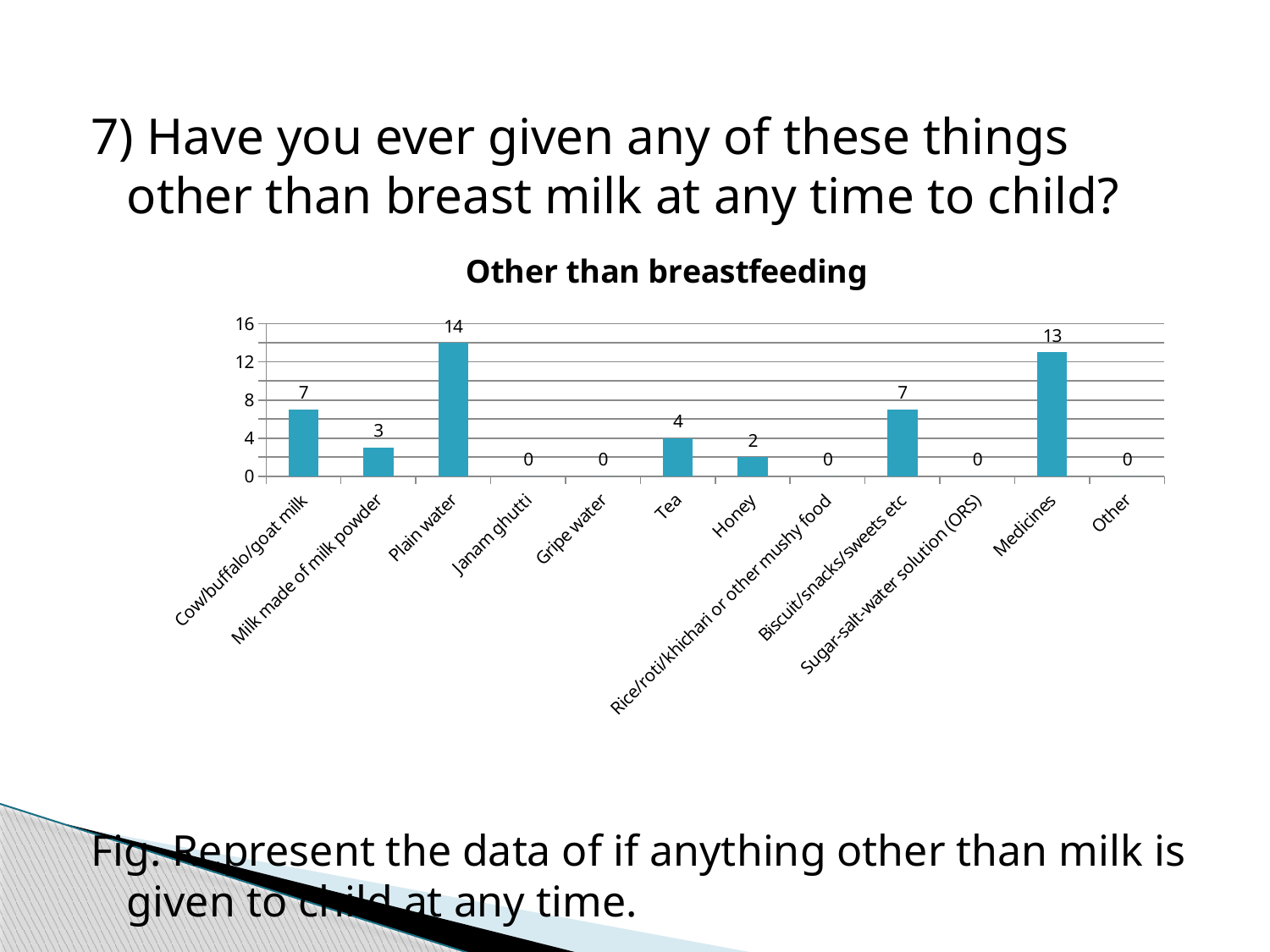
What is the value for Honey? 2 What is the title of the chart? Other than breastfeeding What is the value for Plain water? 14 What is the difference between the values for Plain water and Medicines? 1 Which category has the highest value? Plain water What is the value for Milk made of milk powder? 3 Which is larger, the value for Tea or the value for Honey? Tea What kind of chart is this? Bar chart What is the value for Medicines? 13 How many categories are shown on the x axis? 12 What is the difference between the values for Cow/buffalo/goat milk and Tea? 3 Is the value for Medicines greater or less than 12? greater